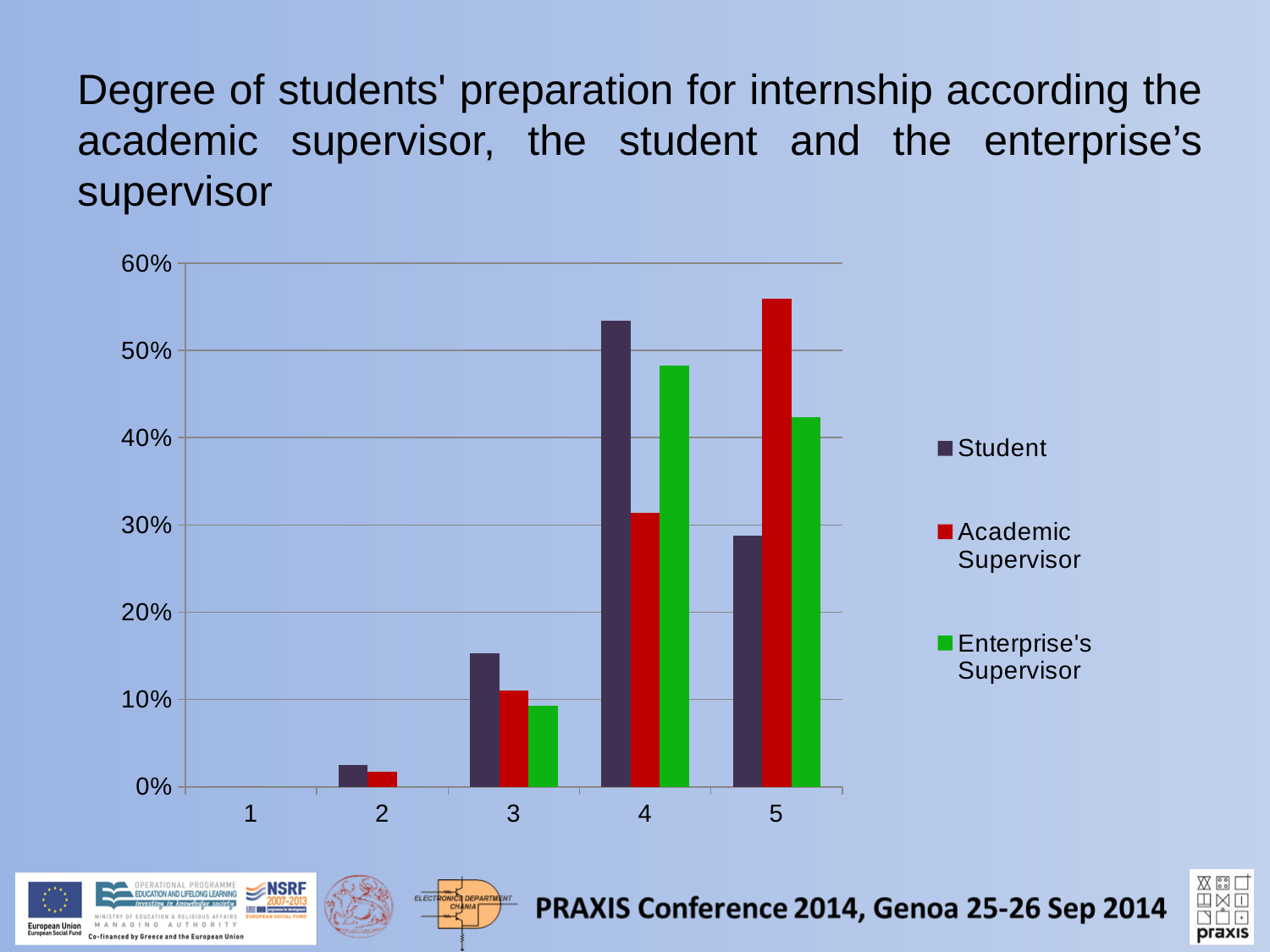
Is the Student value for category 4 greater or less than 50%? greater For the Enterprise's Supervisor series, which category has the highest value? 4 How many series does the legend list? 3 In category 4, which series has the larger value: Student or Academic Supervisor? Student Is the Academic Supervisor value for category 3 greater or less than 20%? less How many categories are shown on the x axis? 5 What kind of chart is shown on the slide? bar chart In category 5, which series has the larger value: Academic Supervisor or Enterprise's Supervisor? Academic Supervisor Which colour represents the Academic Supervisor series in the legend? red Is the Enterprise's Supervisor value for category 5 greater or less than 40%? greater For the Academic Supervisor series, which category has the highest value? 5 For the Student series, which category has the highest value? 4